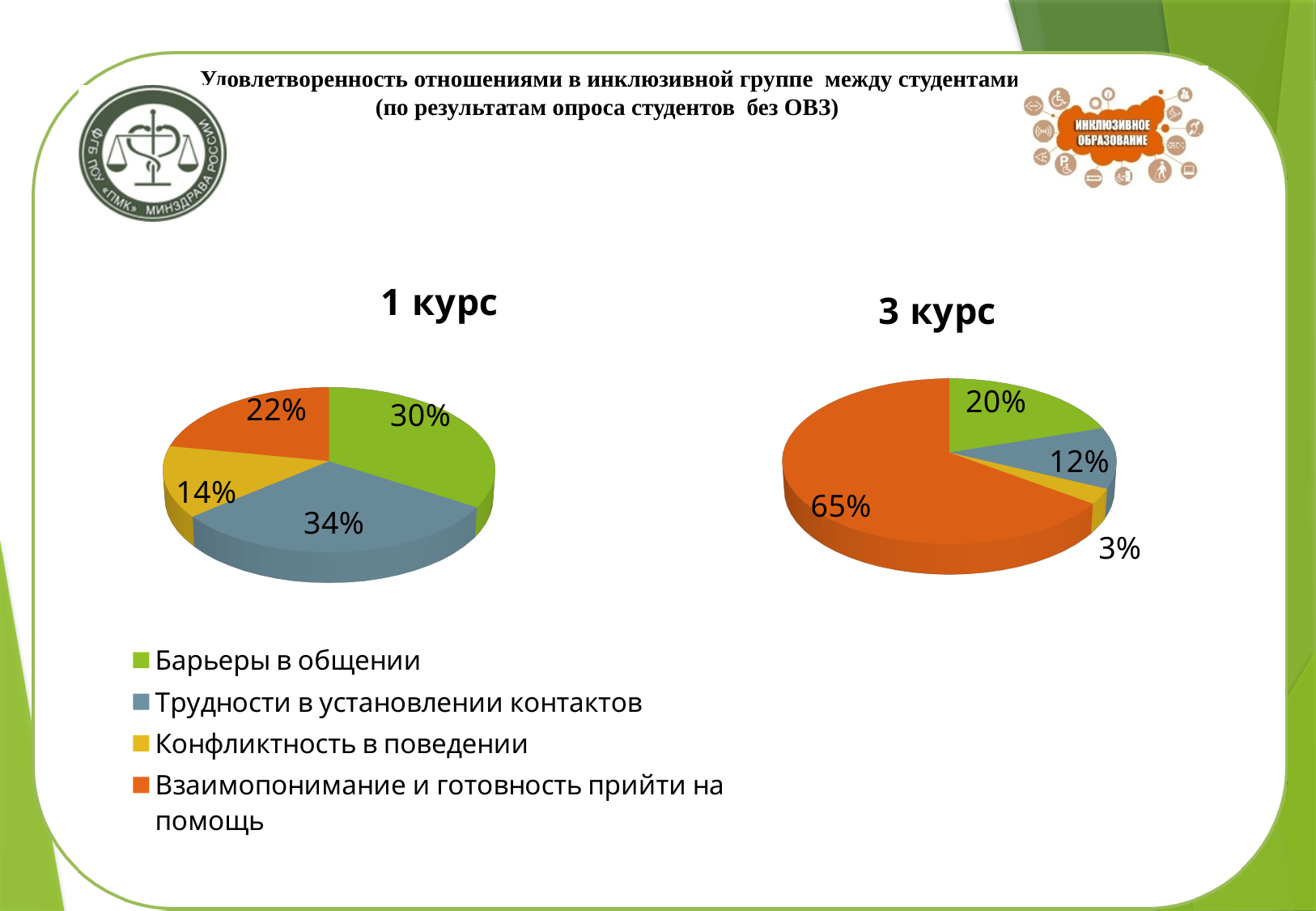
How many categories does the legend list? 4 In the "3 курс" chart, what share is labelled for "Барьеры в общении"? 20% In the "1 курс" chart, what share is labelled for "Трудности в установлении контактов"? 34% In the "1 курс" chart, what share is labelled for "Конфликтность в поведении"? 14% In the "3 курс" chart, what share is labelled for "Взаимопонимание и готовность прийти на помощь"? 65% Which colour represents "Конфликтность в поведении" in the legend? Yellow In the "3 курс" chart, which category has the smallest slice? Конфликтность в поведении In the "1 курс" chart, which category has the largest slice? Трудности в установлении контактов In the "3 курс" chart, what is the difference between the shares for "Барьеры в общении" and "Трудности в установлении контактов"? 8% What kind of chart is the "3 курс" chart? Pie chart Which chart shows a larger share for "Взаимопонимание и готовность прийти на помощь", "1 курс" or "3 курс"? 3 курс In the "1 курс" chart, what is the difference between the shares for "Барьеры в общении" and "Взаимопонимание и готовность прийти на помощь"? 8%